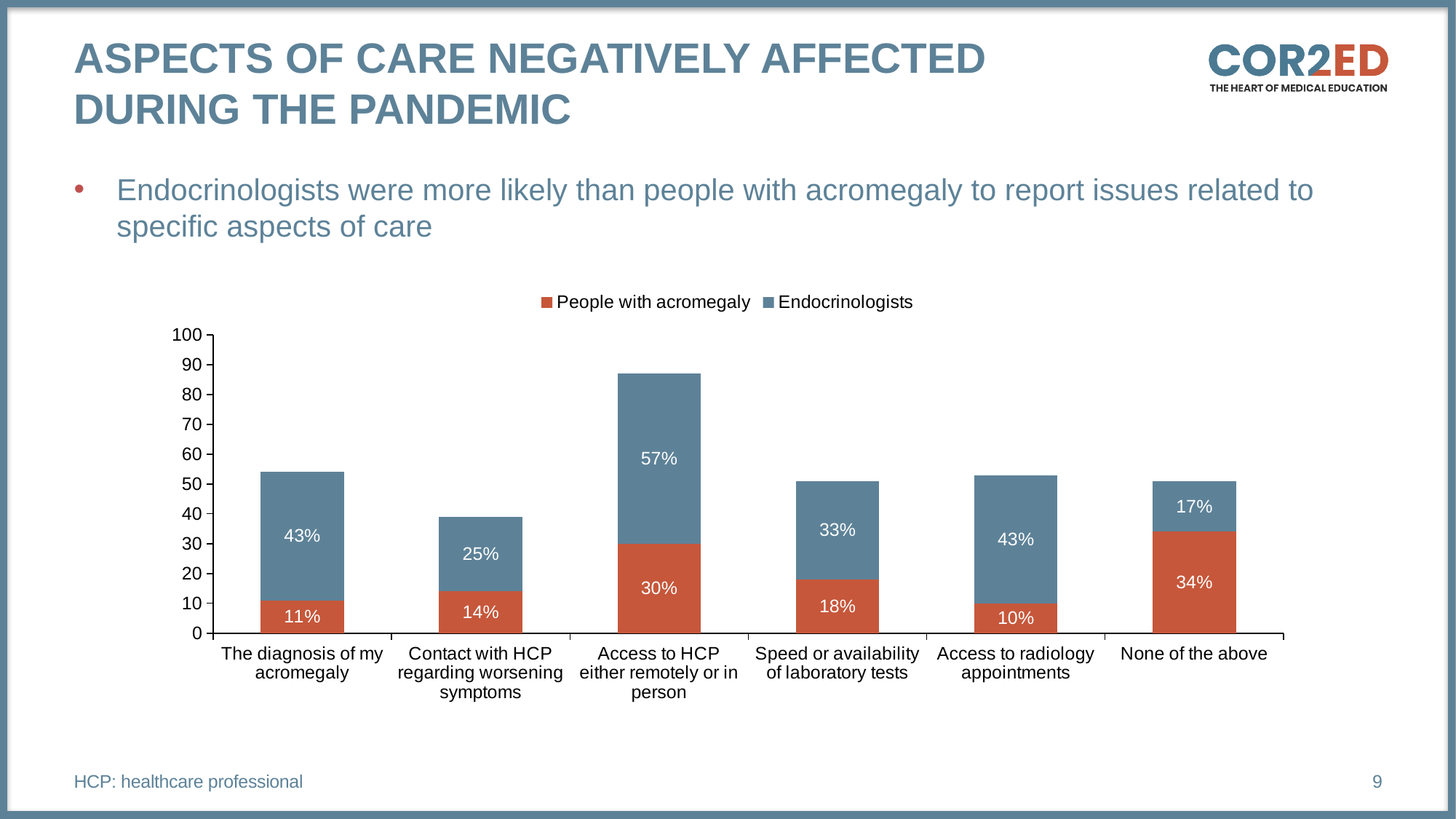
How many categories are shown on the x axis of the chart? 6 Which category has the highest value for endocrinologists? Access to HCP either remotely or in person What type of chart is shown on the slide? Stacked bar chart How many series does the chart legend list? 2 What percentage of endocrinologists reported 'Speed or availability of laboratory tests' as negatively affected? 33% What percentage of people with acromegaly reported 'Access to HCP either remotely or in person' as negatively affected? 30% What is the difference between the endocrinologists' and people with acromegaly's values for 'The diagnosis of my acromegaly'? 32% What is the total height of the stacked bar for 'Contact with HCP regarding worsening symptoms'? 39% What is the total height of the stacked bar for 'Access to HCP either remotely or in person'? 87% Which category has the lowest value for people with acromegaly? Access to radiology appointments What is the value for endocrinologists for 'None of the above'? 17% For 'None of the above', which group has the larger value: people with acromegaly or endocrinologists? People with acromegaly